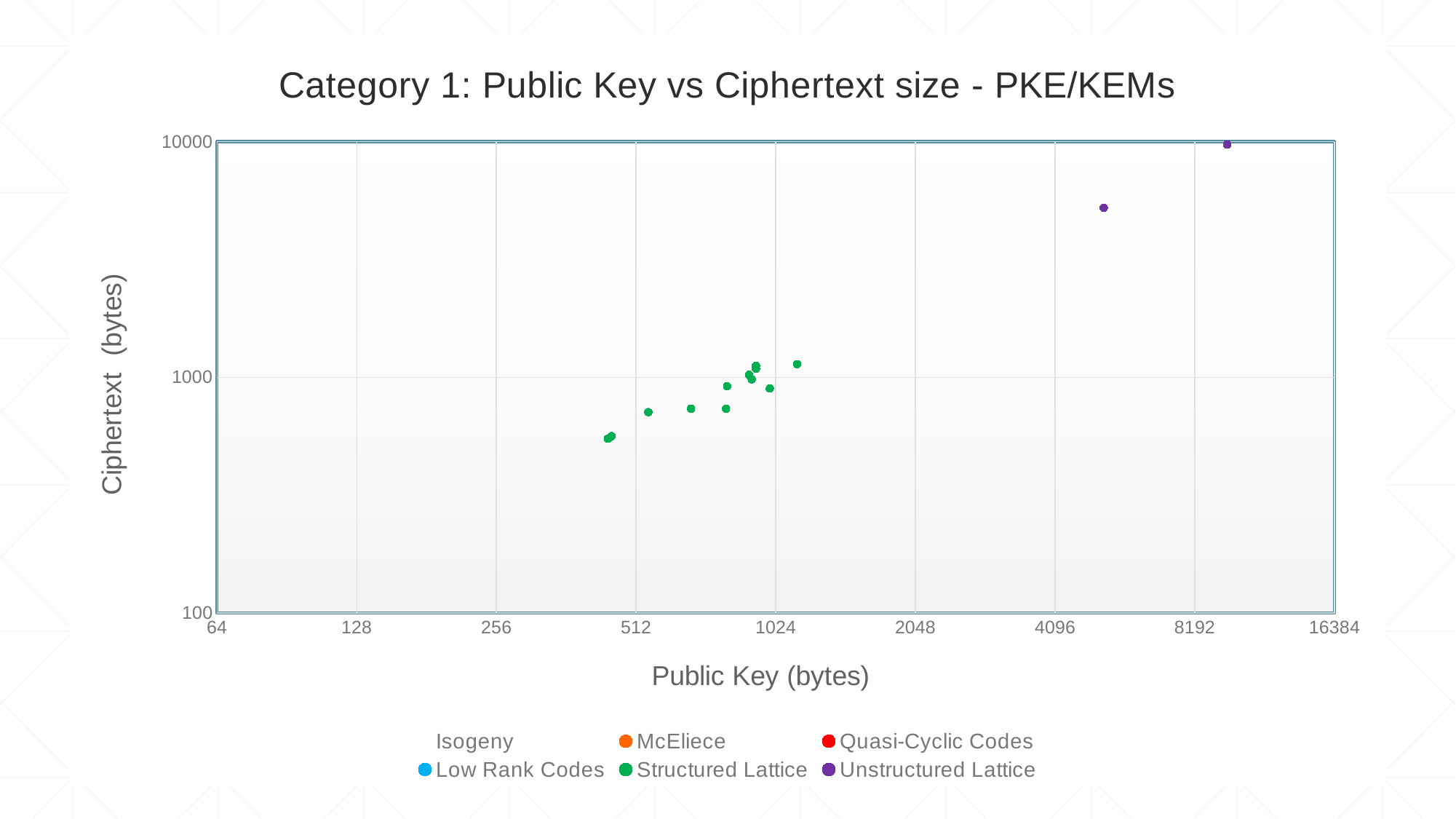
How many Unstructured Lattice points are plotted? 2 Are the public key sizes of the Unstructured Lattice points greater or less than 4096 bytes? greater Are the public key sizes of the Structured Lattice points greater or less than 2048 bytes? less What is the label of the x axis? Public Key (bytes) How many series does the legend list? 6 What is the title of the chart? Category 1: Public Key vs Ciphertext size - PKE/KEMs Which series has the point with the lowest public key size? Structured Lattice Which series has the point with the highest ciphertext size? Unstructured Lattice What kind of chart is shown on the slide? scatter plot Are the ciphertext sizes of the Structured Lattice points greater or less than 100 bytes? greater Which series has the larger public key sizes, Structured Lattice or Unstructured Lattice? Unstructured Lattice